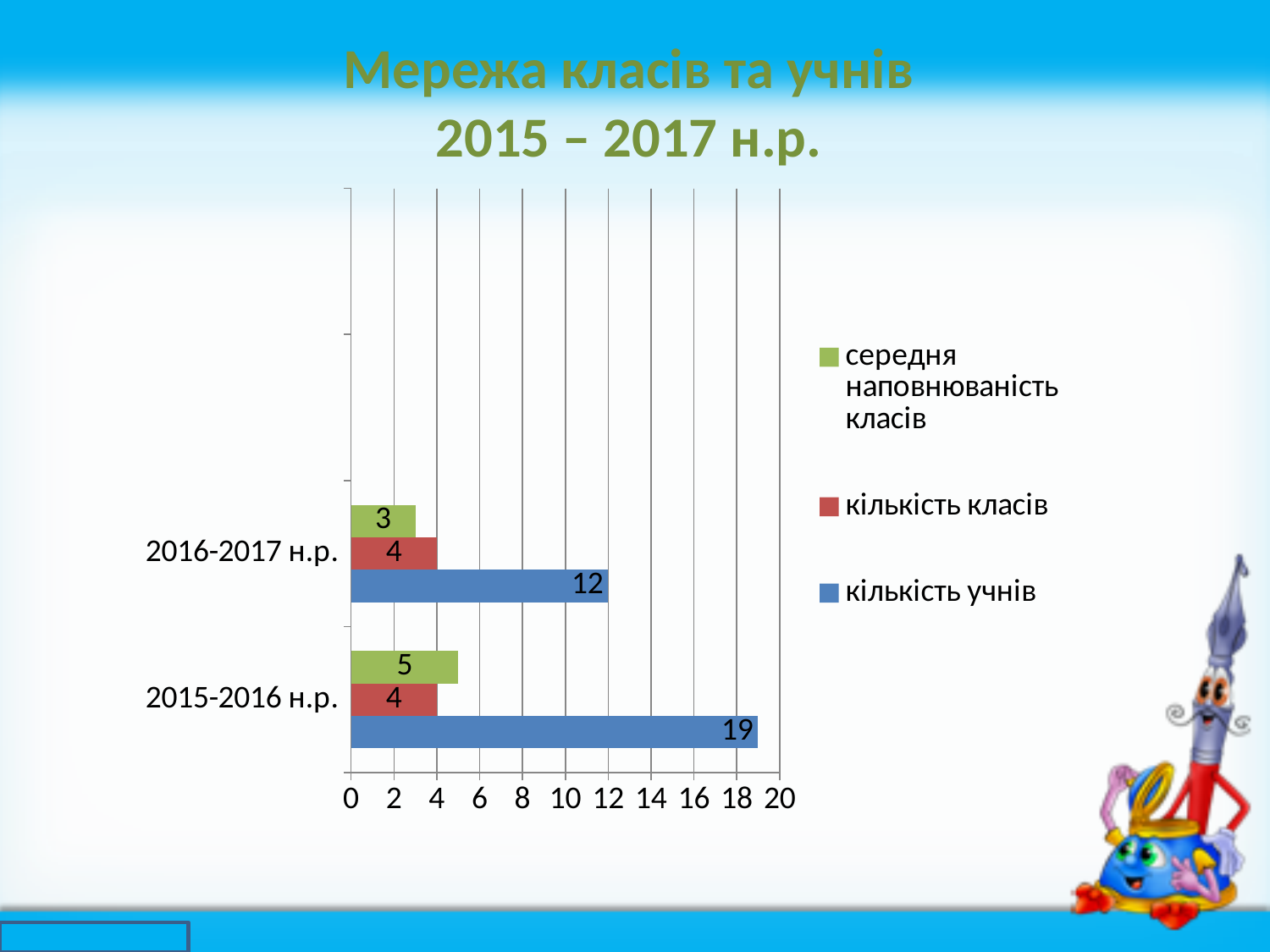
What is the value of середня наповнюваність класів for 2016-2017 н.р.? 3 What is the value of кількість класів for 2015-2016 н.р.? 4 What is the difference in кількість учнів between 2015-2016 н.р. and 2016-2017 н.р.? 7 What is the value of кількість учнів for 2016-2017 н.р.? 12 How many categories (school years) are shown on the chart? 2 Which year has the higher value for кількість учнів? 2015-2016 н.р. What is the value of кількість учнів for 2015-2016 н.р.? 19 Which colour represents кількість учнів in the legend? blue Which year has the lower value for середня наповнюваність класів? 2016-2017 н.р. Is the value of середня наповнюваність класів larger for 2015-2016 н.р. or for 2016-2017 н.р.? 2015-2016 н.р. What type of chart is shown on the slide? bar chart How many series does the legend list? 3